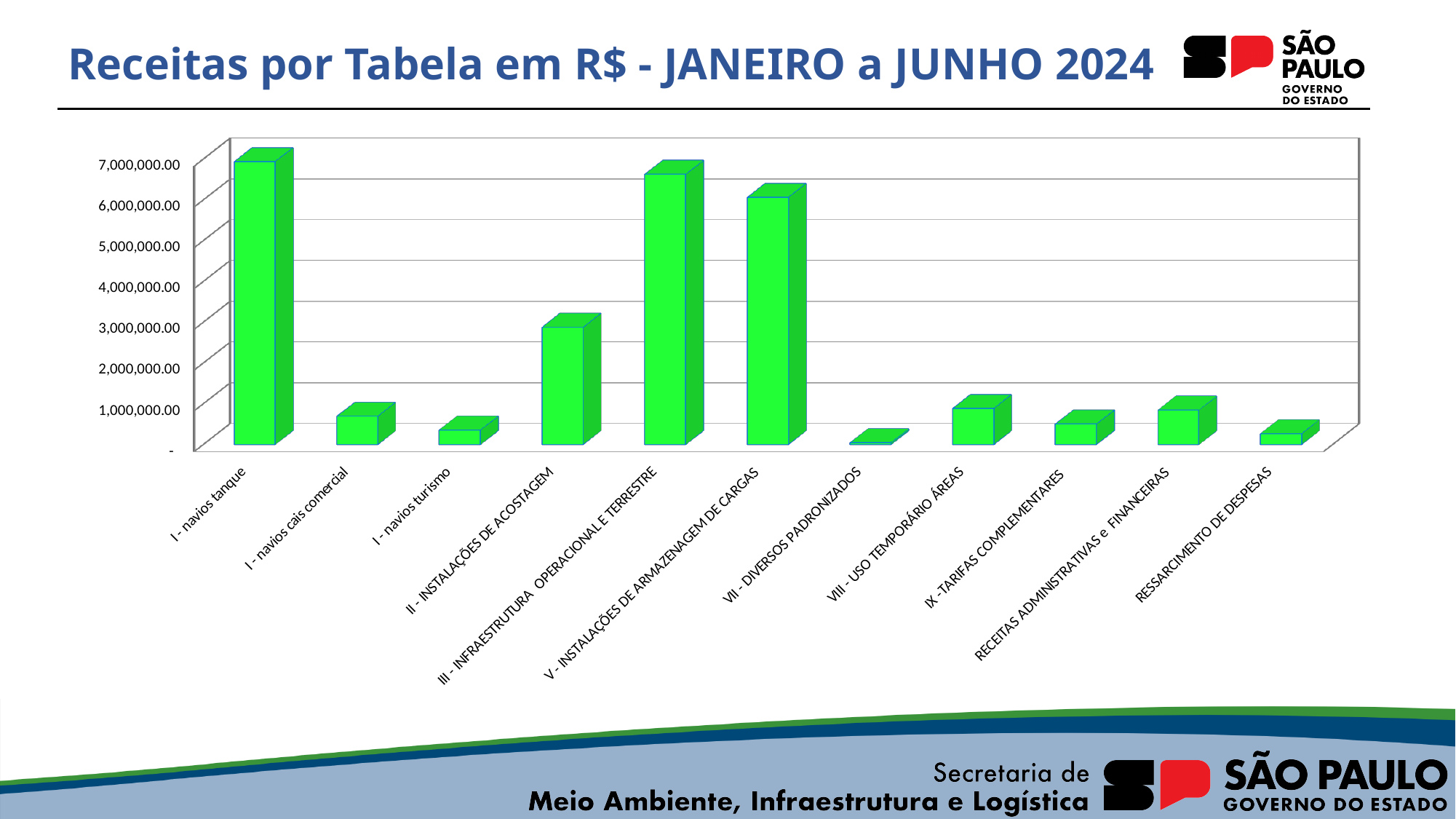
Is the value for V - INSTALAÇÕES DE ARMAZENAGEM DE CARGAS greater or less than 7,000,000.00? less What is the title of the chart on the slide? Receitas por Tabela em R$ - JANEIRO a JUNHO 2024 What kind of chart is shown on the slide? bar chart Which category has the lowest value in the chart? VII - DIVERSOS PADRONIZADOS What colour are the bars in the chart? green Which is larger: the value for I - navios turismo or the value for III - INFRAESTRUTURA OPERACIONAL E TERRESTRE? III - INFRAESTRUTURA OPERACIONAL E TERRESTRE How many categories are plotted on the x axis of the chart? 11 Which is larger: the value for II - INSTALAÇÕES DE ACOSTAGEM or the value for V - INSTALAÇÕES DE ARMAZENAGEM DE CARGAS? V - INSTALAÇÕES DE ARMAZENAGEM DE CARGAS Is the value for III - INFRAESTRUTURA OPERACIONAL E TERRESTRE greater or less than 6,000,000.00? greater Which category has the highest value in the chart? I - navios tanque Is the value for II - INSTALAÇÕES DE ACOSTAGEM greater or less than 2,000,000.00? greater